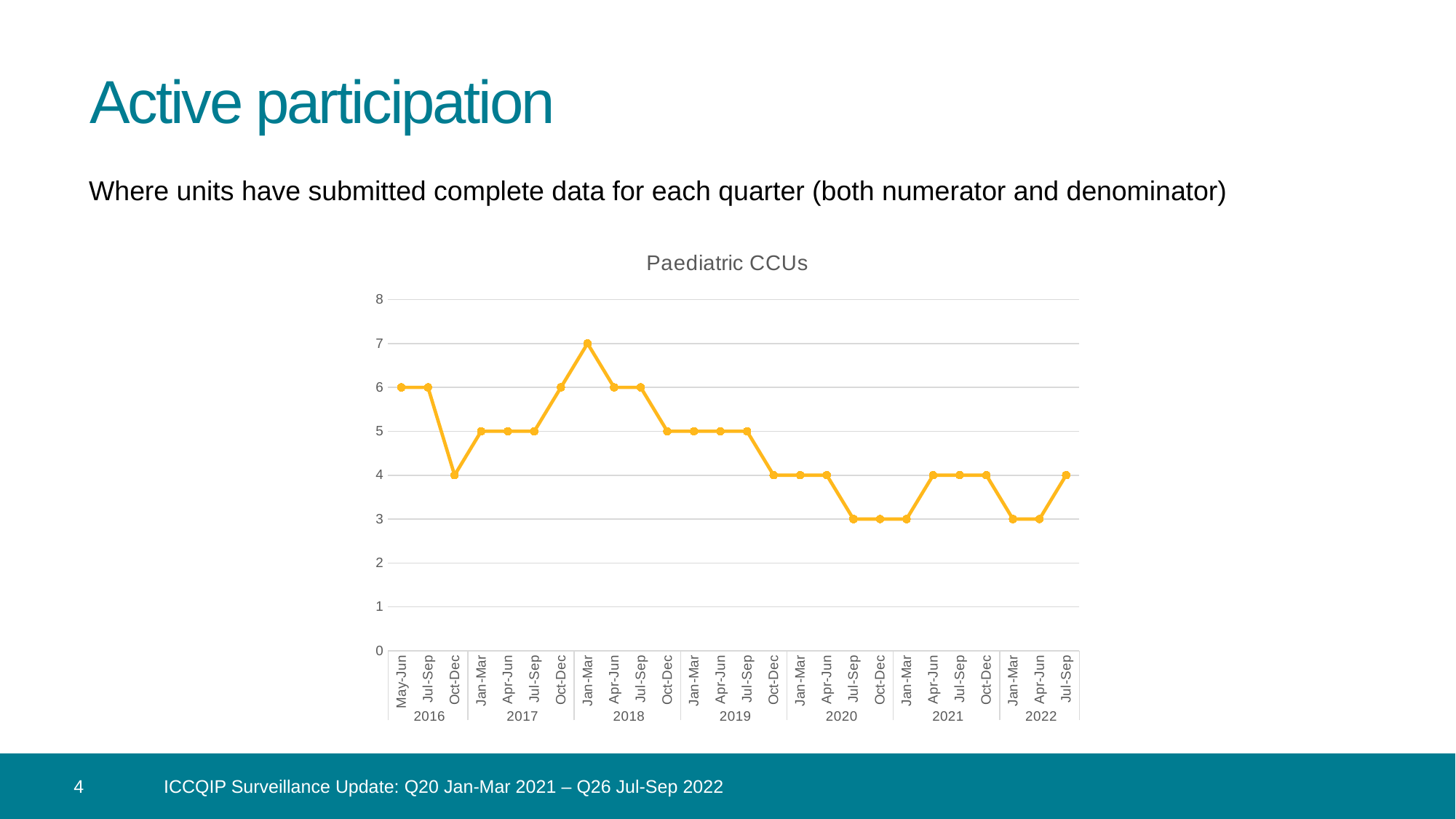
What type of chart is shown on the slide? line chart Which is larger, the value for May-Jun 2016 or the value for Apr-Jun 2021? May-Jun 2016 What is the value for Oct-Dec 2016? 4 What is the value for Jul-Sep 2022? 4 Overall, do the values rise or fall from 2016 to 2022? fall Which quarter has the highest value? Jan-Mar 2018 What is the title of the chart? Paediatric CCUs What is the value for Jan-Mar 2018? 7 What is the lowest value plotted on the chart? 3 What is the difference between the value for Jan-Mar 2018 and the value for Jan-Mar 2022? 4 How many data points are plotted on the chart? 26 What is the value for Jan-Mar 2021? 3